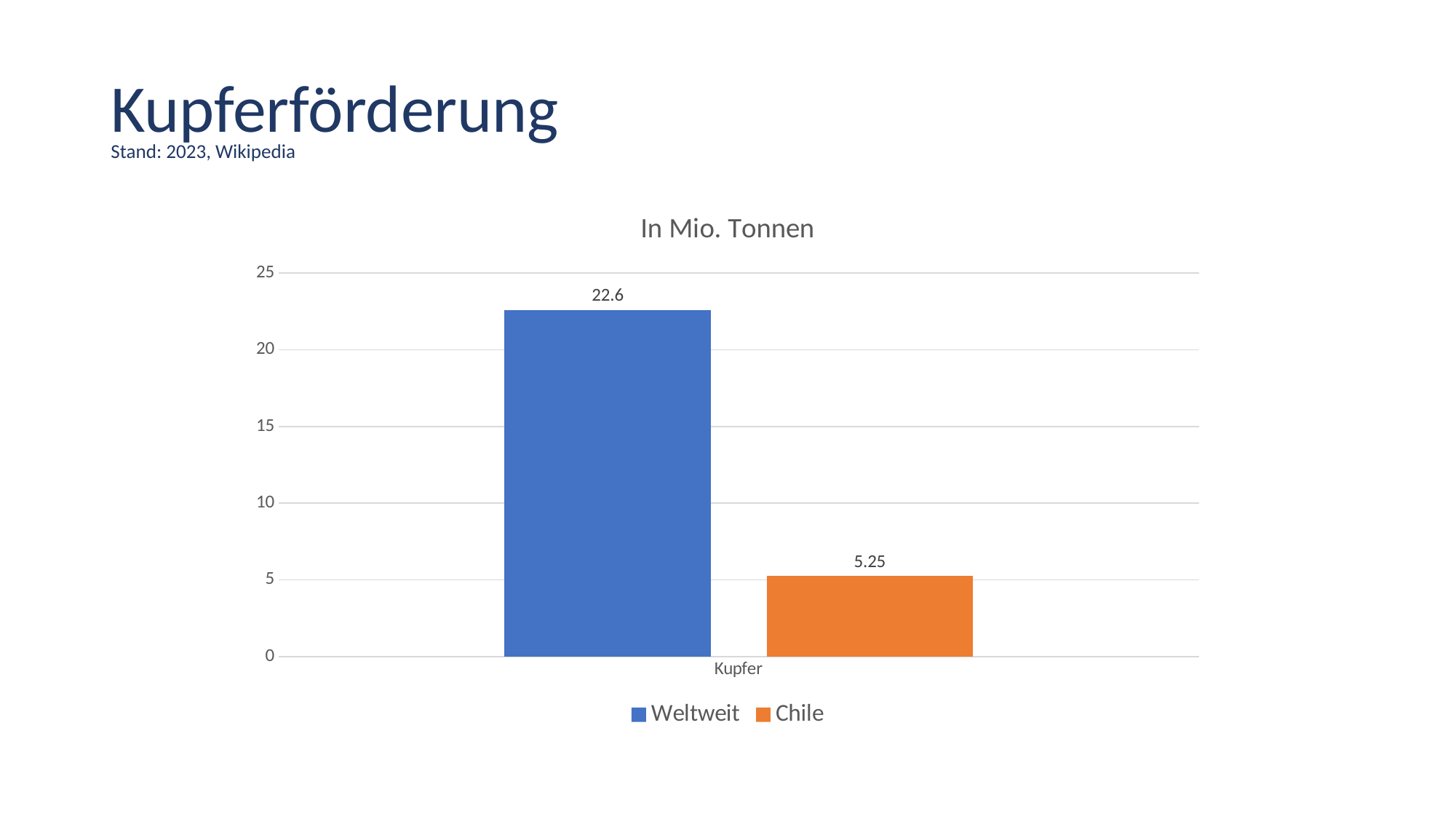
How many series does the legend list? 2 What is the difference between the Weltweit value and the Chile value? 17.35 Which series has the highest value in the chart? Weltweit Is the value for Chile greater or less than 10? less Which series has the higher value, Weltweit or Chile? Weltweit What is the title of the chart? In Mio. Tonnen What is the value for Chile in the chart? 5.25 Which series has the lowest value in the chart? Chile What is the value for Weltweit in the chart? 22.6 What kind of chart is shown on the slide? Bar chart Is the value for Weltweit greater or less than 20? greater What is the category label on the x axis? Kupfer